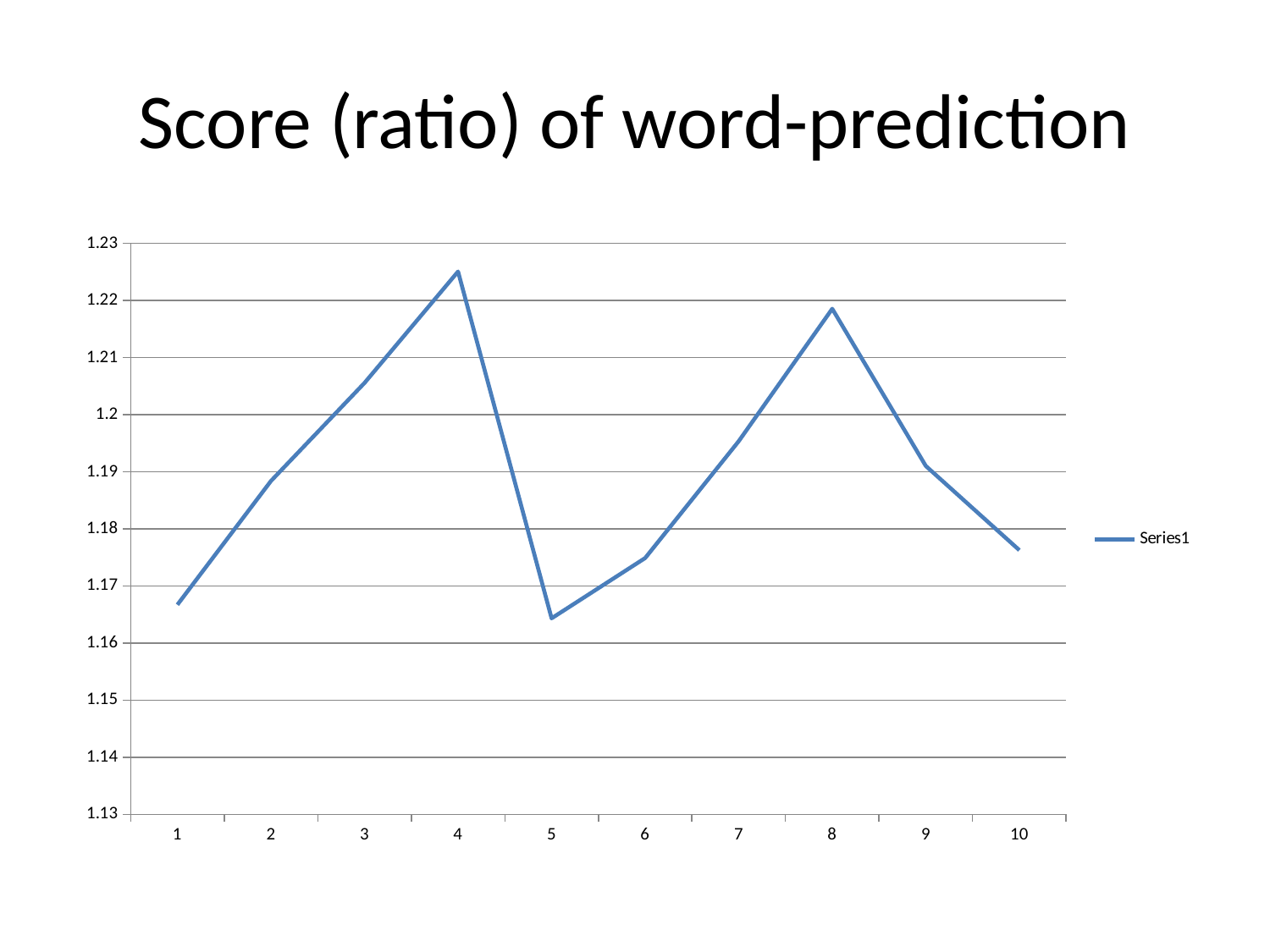
At which x-axis point does the line reach its lowest value? 5 Which has the larger value, point 4 or point 8? point 4 Is the value at point 5 greater or less than 1.17? less Is the value at point 1 greater or less than 1.17? less Is the value at point 4 greater or less than 1.22? greater How many points are plotted along the x axis? 10 What kind of chart is shown on the slide? line chart At which x-axis point does the line reach its highest value? 4 What is the title of the chart? Score (ratio) of word-prediction Does the line rise or fall from point 1 to point 4? rise How many series does the legend list? 1